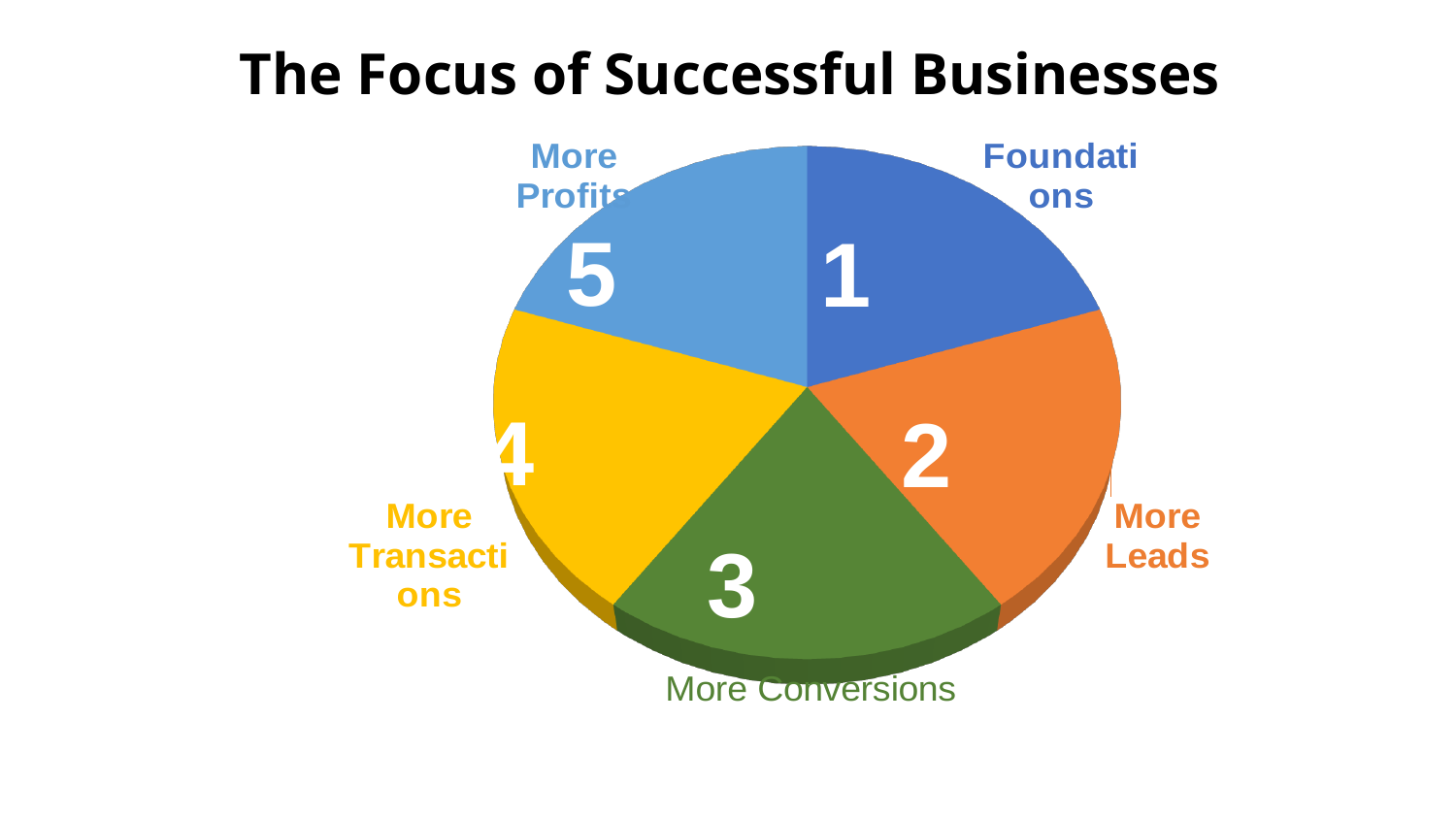
Which slice of the pie chart is coloured green? More Conversions Which number is printed on the slice labelled More Leads? 2 What kind of chart is shown on the slide? Pie chart Which number is printed on the slice labelled More Transactions? 4 What is the title of the slide containing the pie chart? The Focus of Successful Businesses Which number is printed on the slice labelled Foundations? 1 How many slices does the pie chart have? 5 Which number is printed on the slice labelled More Profits? 5 Which number is printed on the slice labelled More Conversions? 3 Which slice label is numbered 4 in the pie chart? More Transactions